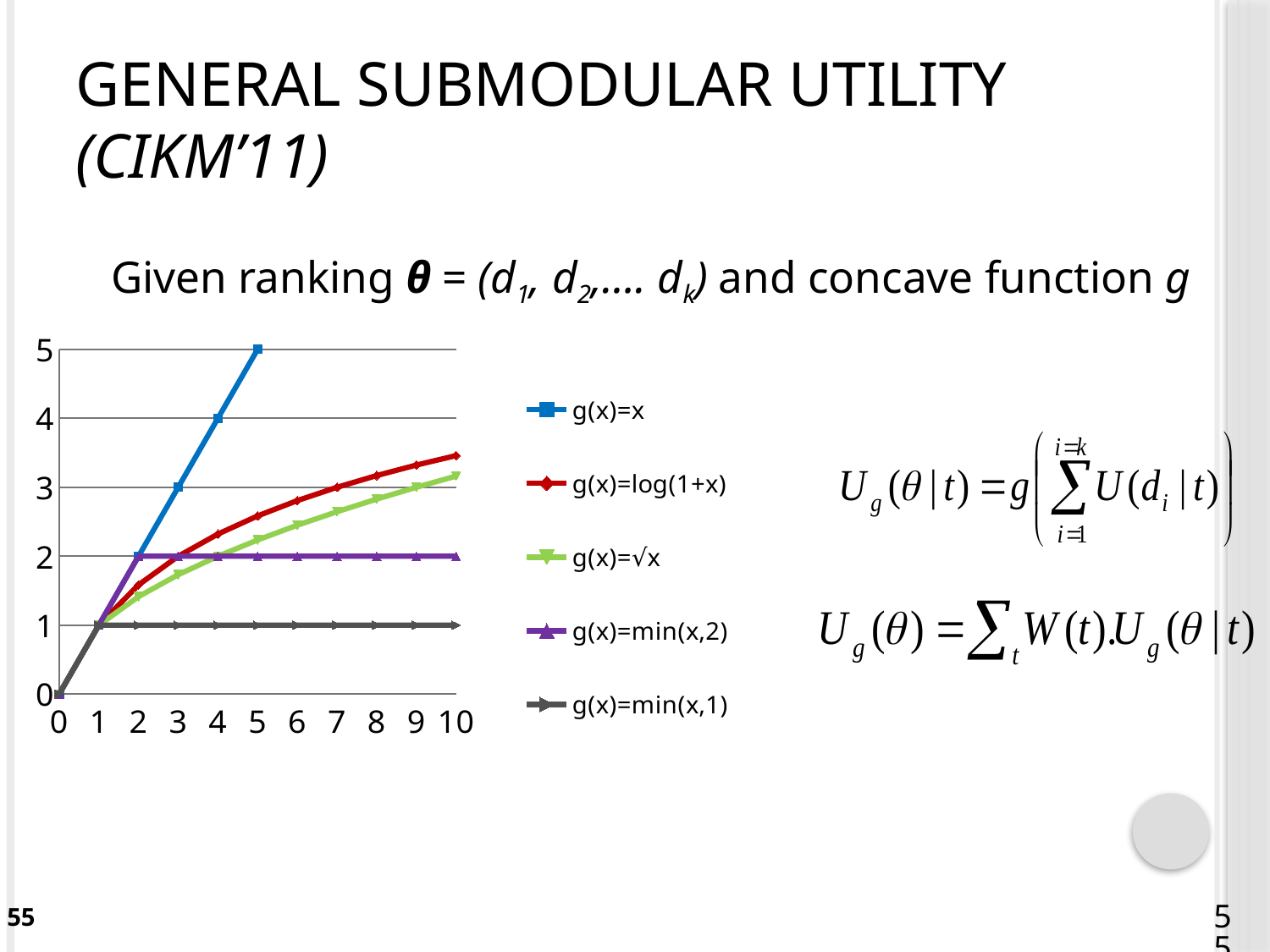
What kind of chart is shown on the slide? line chart What is the value of g(x)=x at x=5? 5 Is the value of g(x)=log(1+x) at x=10 greater or less than 3? greater What is the value of g(x)=√x at x=4? 2 Is the value of g(x)=log(1+x) at x=5 greater or less than 3? less At x=10, which series has the lowest value? g(x)=min(x,1) What is the value of g(x)=min(x,2) at x=10? 2 Does the g(x)=min(x,1) series rise, fall, or stay flat between x=1 and x=10? stay flat How many series does the chart legend list? 5 What is the value of g(x)=min(x,1) at x=10? 1 At x=5, which is larger: g(x)=x or g(x)=log(1+x)? g(x)=x